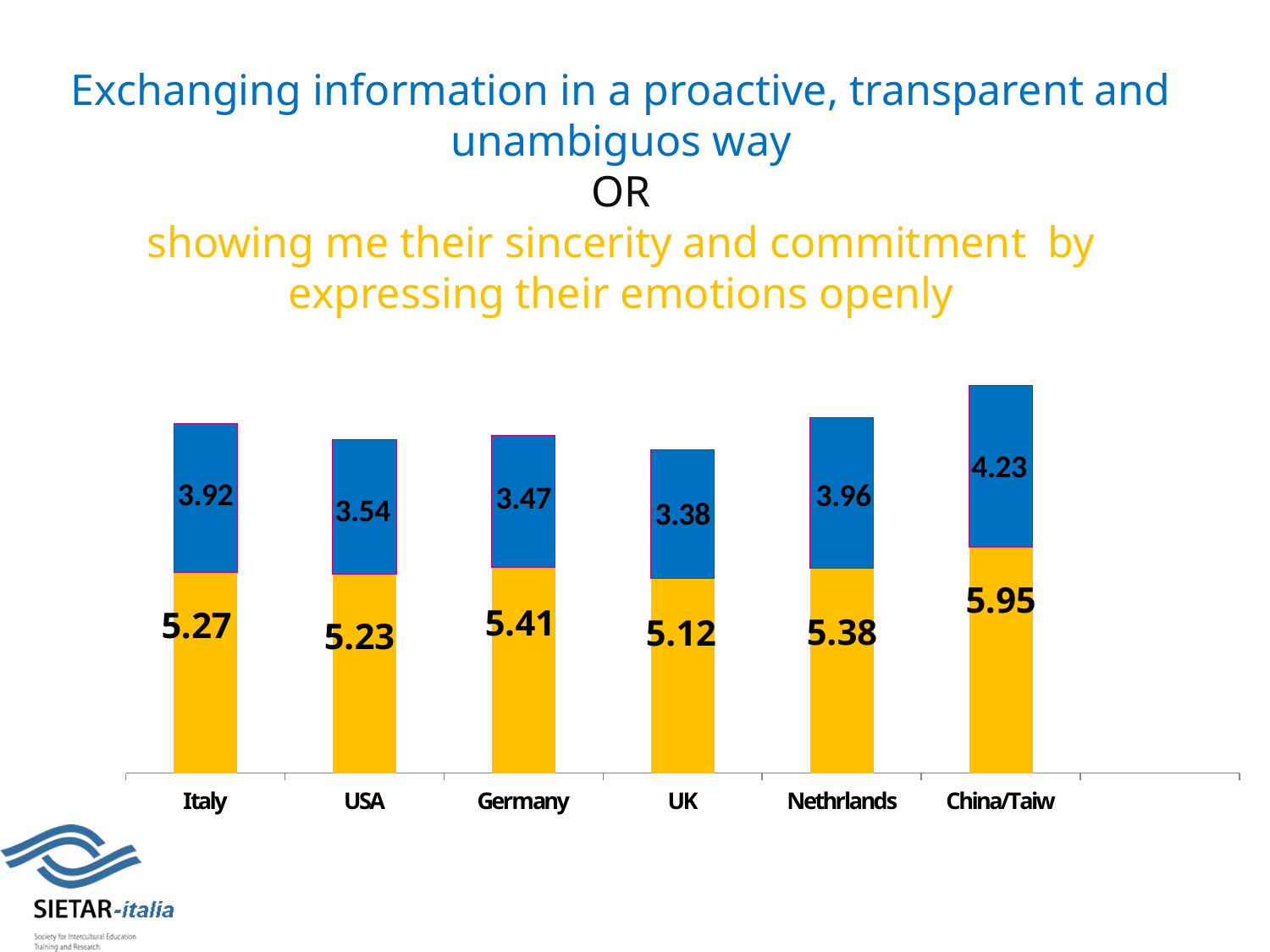
How many categories are shown on the x axis? 6 What is the total of the stacked bar for Italy? 9.19 Which category has the lowest yellow segment value? UK What kind of chart is shown on the slide? Stacked bar chart What is the value of the yellow segment for Germany? 5.41 What is the value of the blue segment for China/Taiw? 4.23 Which category has the lowest blue segment value? UK What is the difference between the yellow segment values for China/Taiw and UK? 0.83 Which category has the highest yellow segment value? China/Taiw What is the total of the stacked bar for China/Taiw? 10.18 What is the value of the blue segment for UK? 3.38 Which has a larger blue segment value, Italy or Nethrlands? Nethrlands